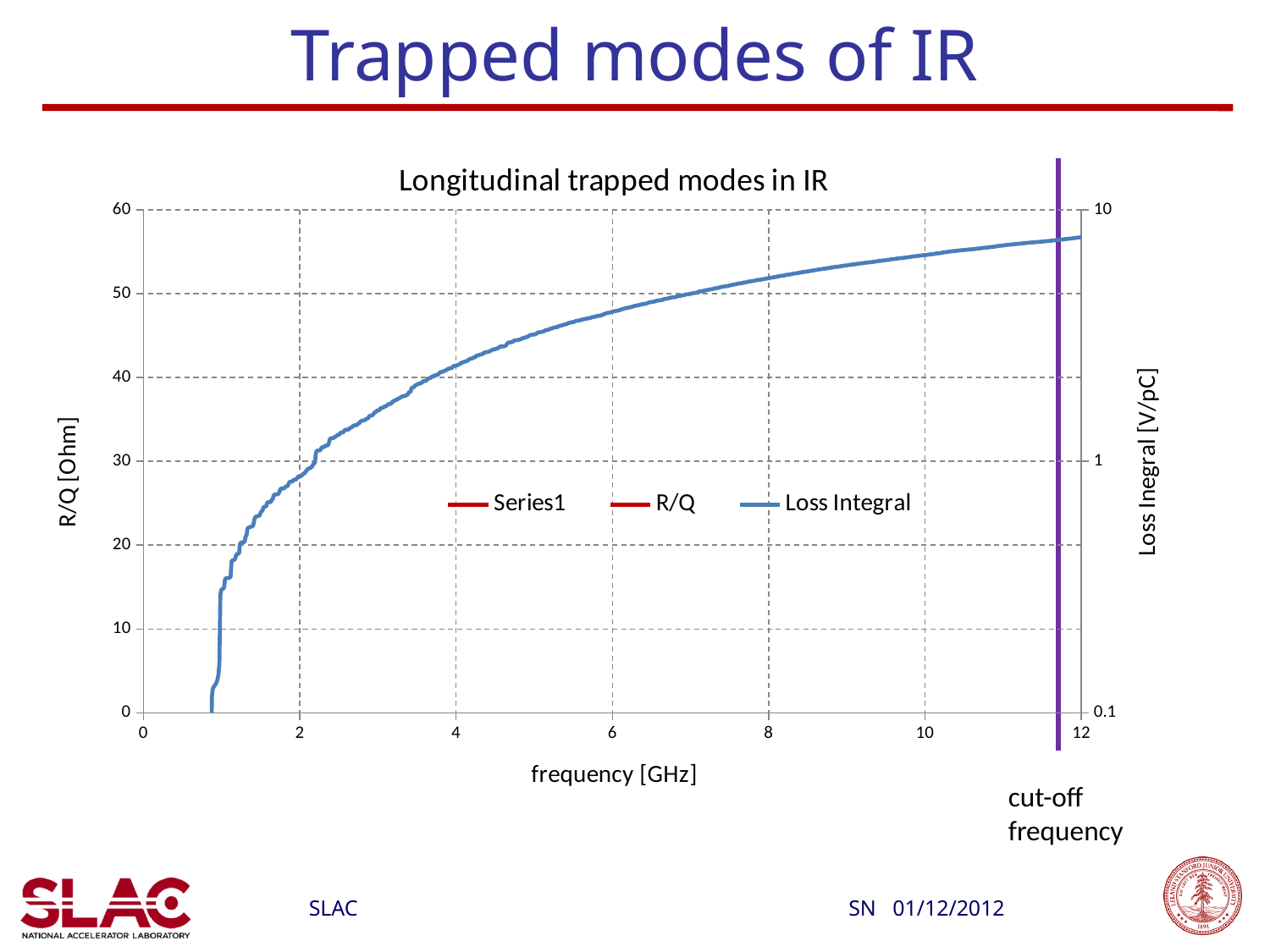
Is the Loss Integral value at 8 GHz greater or less than the value at 2 GHz? greater Is the cut-off frequency marked by the vertical line greater or less than 10 GHz? greater What is the label of the x axis? frequency [GHz] What kind of chart is shown on the slide? line chart At a frequency of 4 GHz, does the Loss Integral curve lie above or below the gridline for 1 on the right axis? above What is the maximum value shown on the right-hand axis? 10 What is the maximum value shown on the x axis? 12 At a frequency of 1 GHz, does the Loss Integral curve lie above or below the gridline for 1 on the right axis? below What is the maximum value shown on the left-hand axis? 60 Does the Loss Integral curve rise or fall as frequency increases? rises What is the title of the chart? Longitudinal trapped modes in IR How many series does the chart legend list? 3